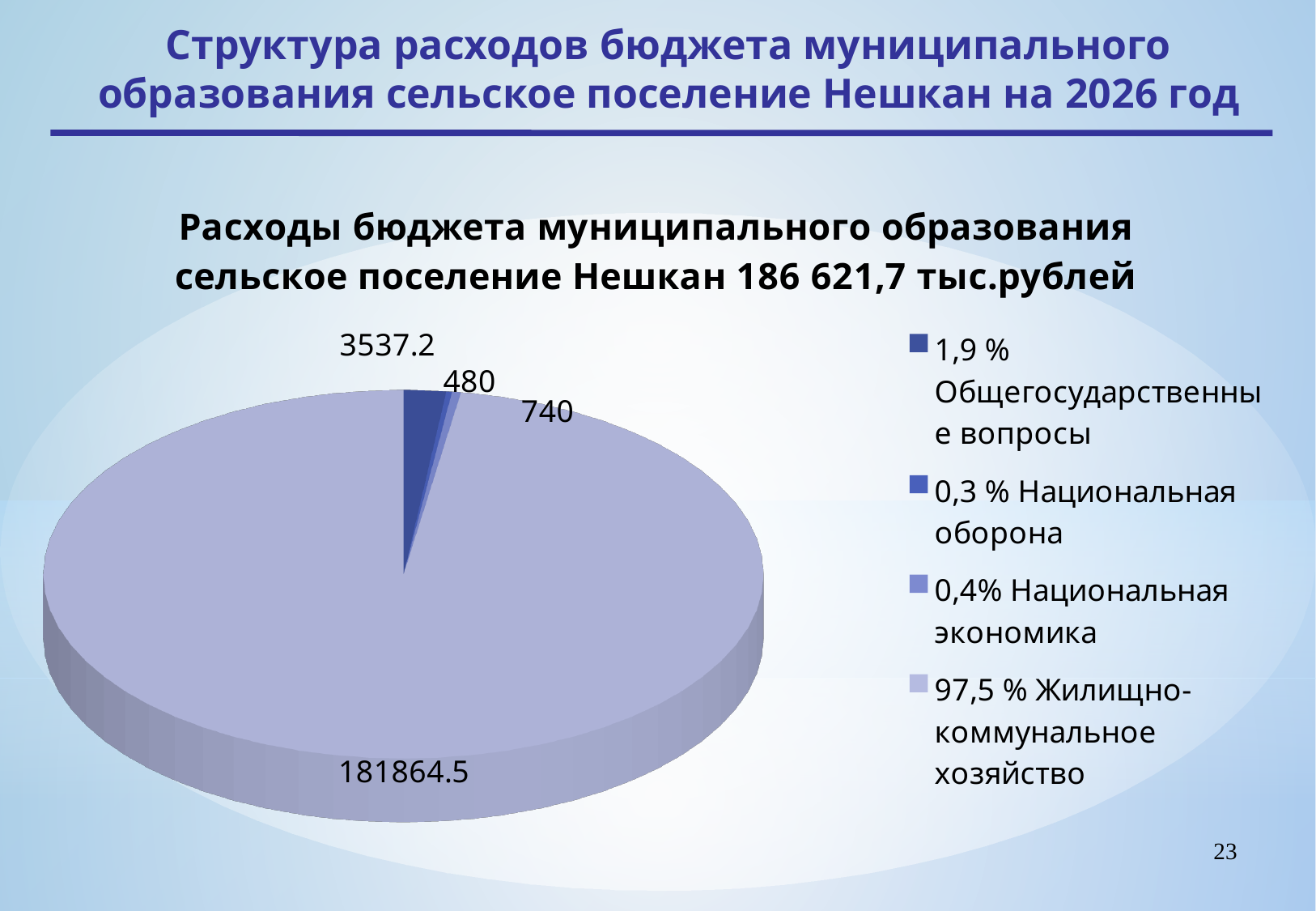
What is the value of the slice for Национальная оборона? 480 What is the value of the slice for Жилищно-коммунальное хозяйство? 181864.5 What is the value of the slice for Общегосударственные вопросы? 3537.2 What share of the pie does Общегосударственные вопросы represent, according to the legend? 1,9 % Which category has the smallest slice in the pie chart? Национальная оборона What is the difference between the values for Национальная экономика and Национальная оборона? 260 What is the value of the slice for Национальная экономика? 740 How many slices does the pie chart have? 4 What share of the pie does Жилищно-коммунальное хозяйство represent, according to the legend? 97,5 % What type of chart is shown on the slide? Pie chart Which is larger: the value for Общегосударственные вопросы or the value for Национальная экономика? Общегосударственные вопросы Which category has the largest slice in the pie chart? Жилищно-коммунальное хозяйство